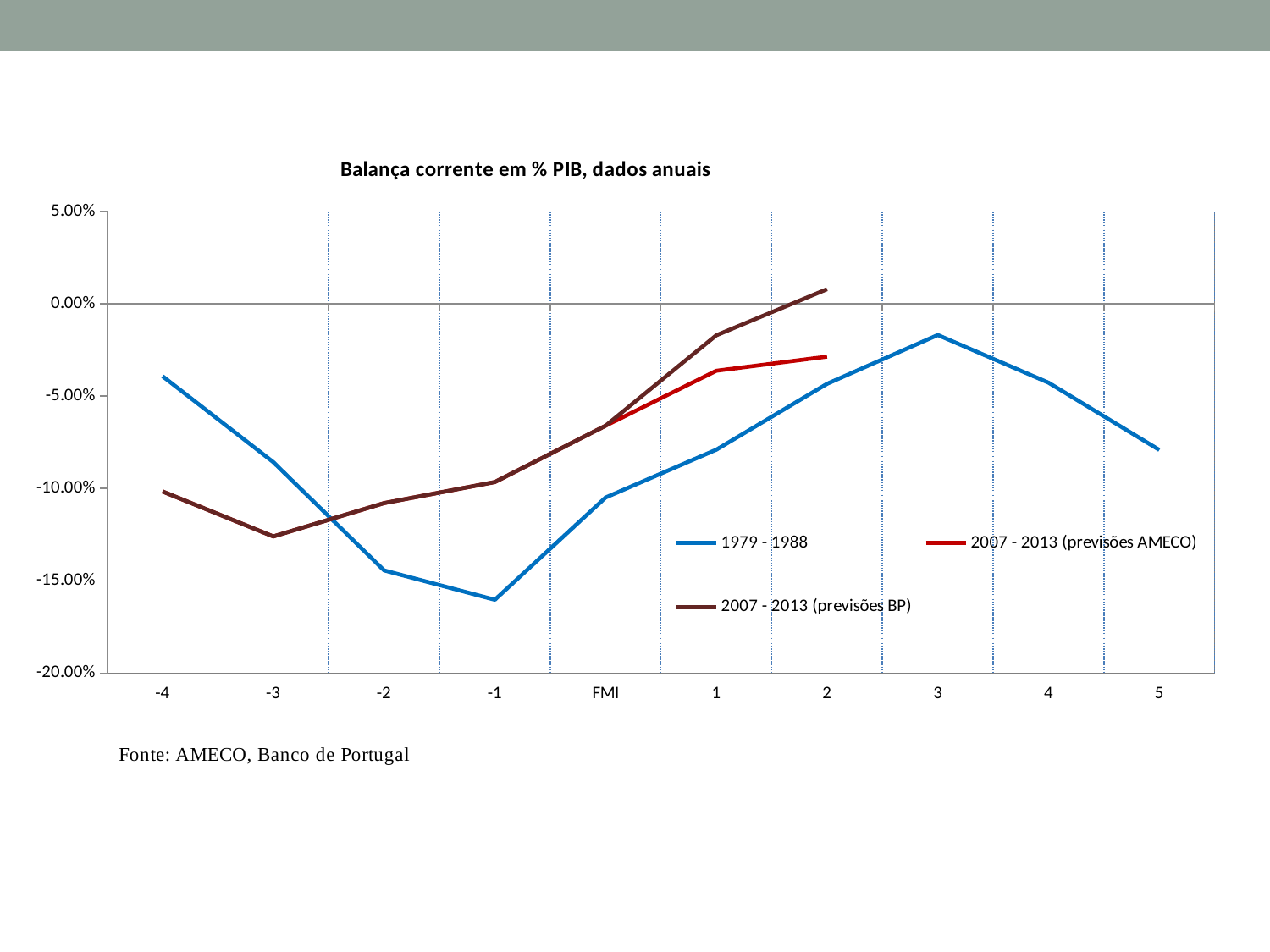
At which x-axis category does the 1979 - 1988 series reach its highest value? 3 Is the value of the 1979 - 1988 series at -1 greater or less than -15.00%? less At which x-axis category does the 1979 - 1988 series reach its lowest value? -1 How many categories are shown on the x axis? 10 Does the 2007 - 2013 (previsões BP) series rise or fall from -3 to 2? rise Which series is drawn in red? 2007 - 2013 (previsões AMECO) What is the title of the chart? Balança corrente em % PIB, dados anuais What kind of chart is shown on the slide? line chart At which x-axis category does the 2007 - 2013 (previsões BP) series reach its lowest value? -3 Is the value of the 2007 - 2013 (previsões BP) series at 2 greater or less than 0.00%? greater At category 2, which series has the higher value: 2007 - 2013 (previsões BP) or 2007 - 2013 (previsões AMECO)? 2007 - 2013 (previsões BP) How many series does the legend list? 3